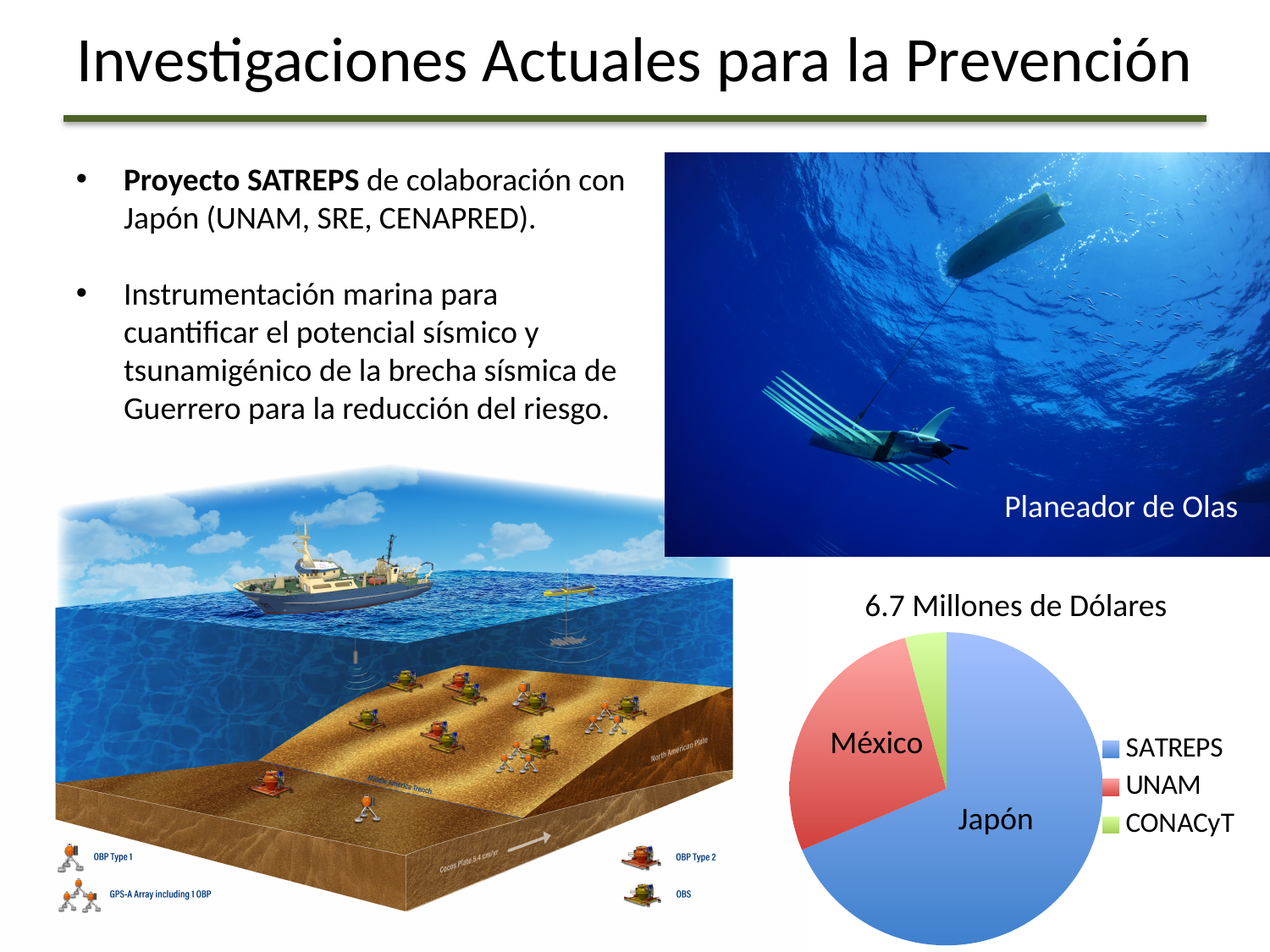
In the pie chart, which is larger, the SATREPS slice or the UNAM slice? SATREPS How many slices does the pie chart have? 3 What kind of chart is shown on the slide? pie chart Which slice of the pie chart is the smallest? CONACyT In the pie chart, which is larger, the UNAM slice or the CONACyT slice? UNAM Which legend entry of the pie chart is shown in green? CONACyT What is the title of the pie chart? 6.7 Millones de Dólares Which slice of the pie chart is the largest? SATREPS How many entries does the pie chart's legend list? 3